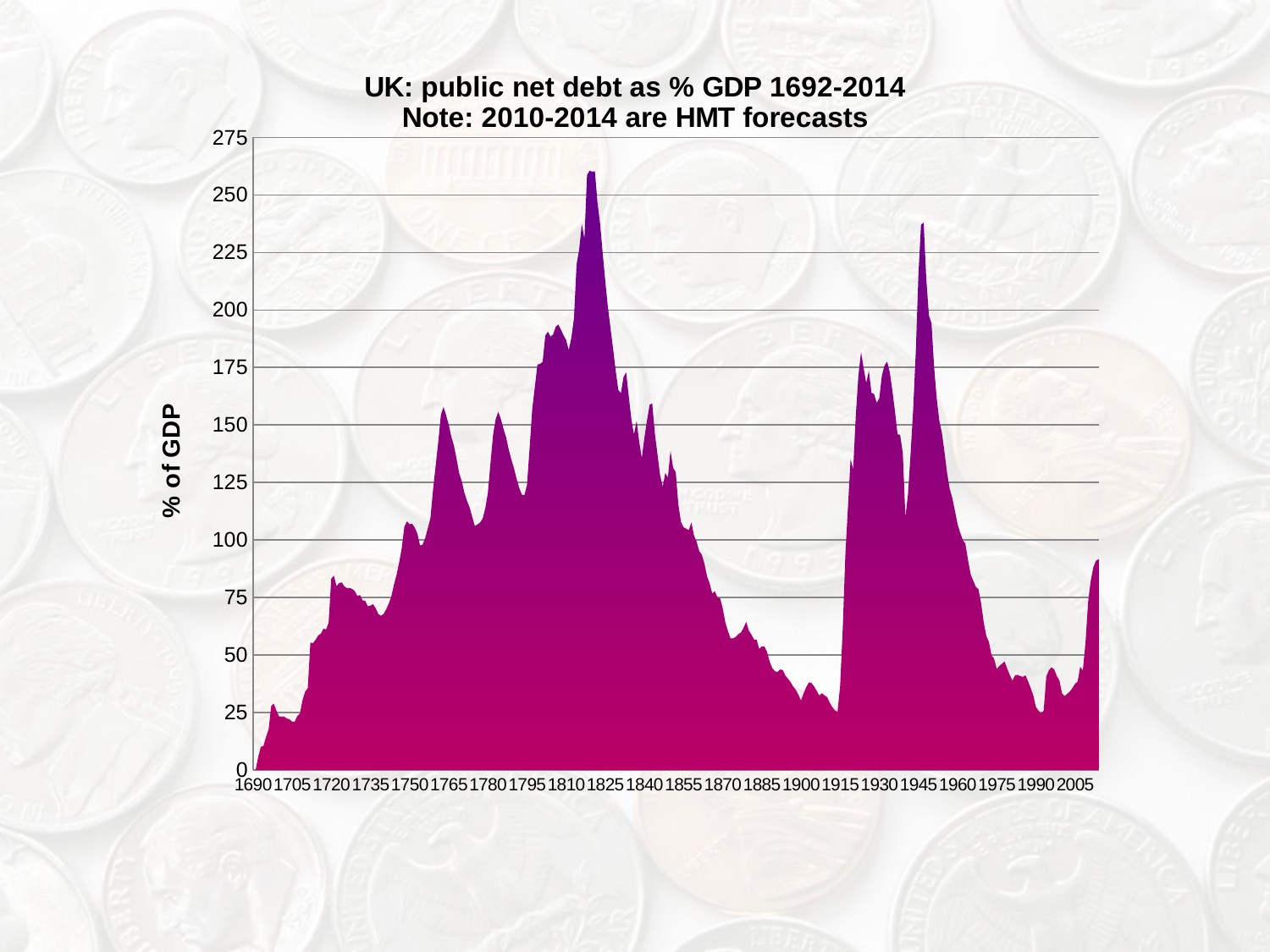
What is the title of the chart? UK: public net debt as % GDP 1692-2014 Note: 2010-2014 are HMT forecasts Does public net debt as % of GDP rise or fall between 1825 and 1900? Fall What is the highest value shown on the y axis? 275 Does public net debt as % of GDP rise or fall between 1690 and 1720? Rise Is the peak value around 1945 greater or less than 225? greater What kind of chart is shown on the slide? Area chart Is the peak value of public net debt around 1820 greater or less than 250? greater Is the value for 1690 greater or less than 25? less Which is higher: the peak around 1820 or the peak around 1945? The peak around 1820 What is the label on the y axis of the chart? % of GDP